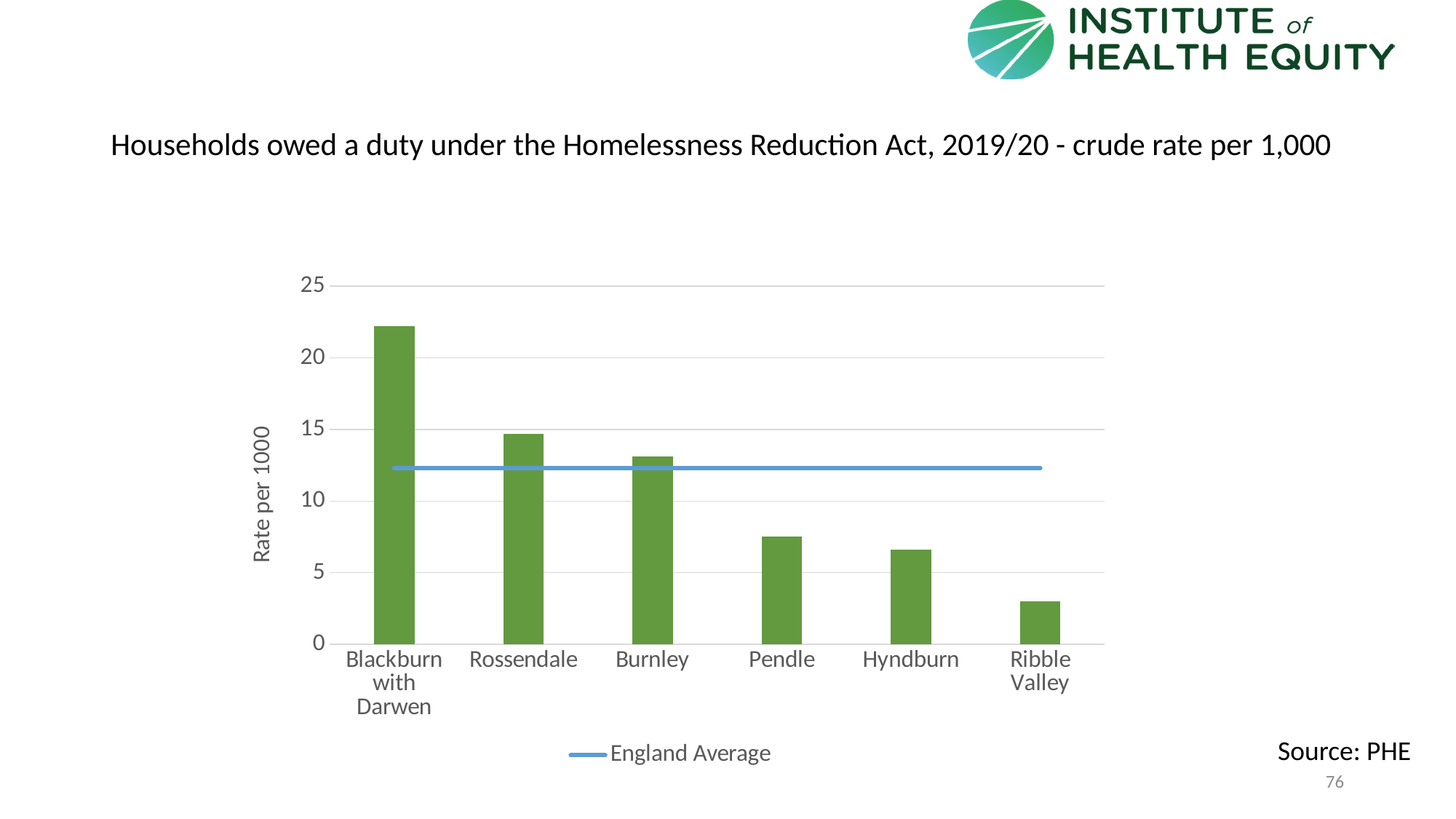
Do the bar values rise or fall moving from left to right along the x axis? fall Which has a higher rate, Hyndburn or Ribble Valley? Hyndburn What kind of chart is shown on the slide? bar chart Is the value for Blackburn with Darwen greater or less than 20? greater Is the value for Ribble Valley greater or less than 5? less Which local authority has the lowest rate of households owed a duty under the Homelessness Reduction Act? Ribble Valley What does the blue horizontal line in the chart represent, according to the legend? England Average Which has a higher rate, Rossendale or Pendle? Rossendale How many local authorities are shown on the x axis of the chart? 6 What is the label on the vertical axis of the chart? Rate per 1000 Which local authority has the highest rate of households owed a duty under the Homelessness Reduction Act? Blackburn with Darwen Is the value for Pendle greater or less than 10? less